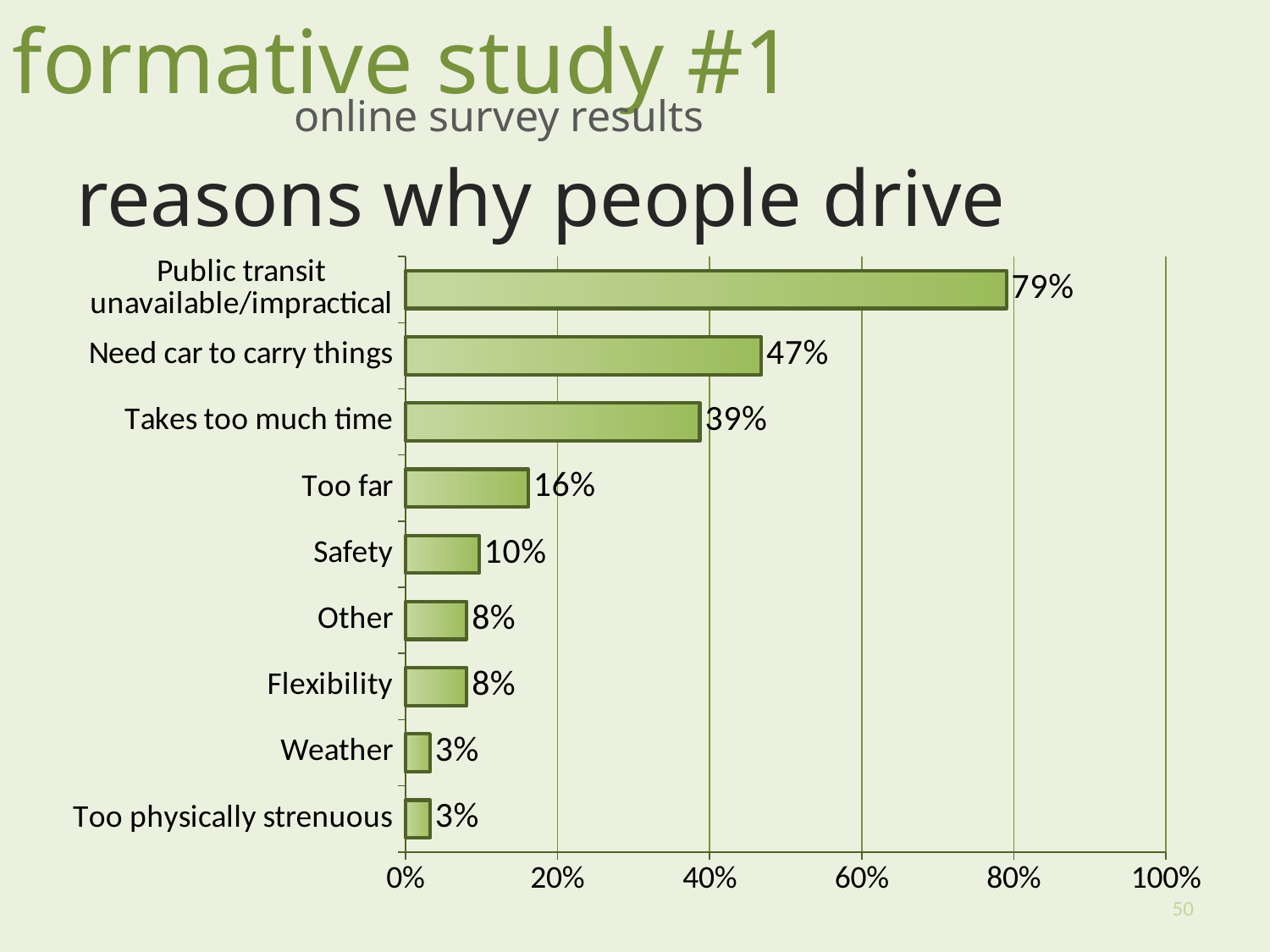
What is the value for 'Safety'? 10% How many reasons are shown in the chart? 9 What is the difference between 'Public transit unavailable/impractical' and 'Need car to carry things'? 32% Which reason has the highest percentage? Public transit unavailable/impractical What is the value for 'Takes too much time'? 39% Is the value for 'Need car to carry things' greater or less than 40%? greater What is the title of the chart? reasons why people drive What is the difference between 'Too far' and 'Safety'? 6% What kind of chart is used to show the reasons why people drive? Bar chart What percentage of respondents cited 'Public transit unavailable/impractical' as a reason for driving? 79% Which is larger, 'Takes too much time' or 'Too far'? Takes too much time What is the value for 'Need car to carry things'? 47%